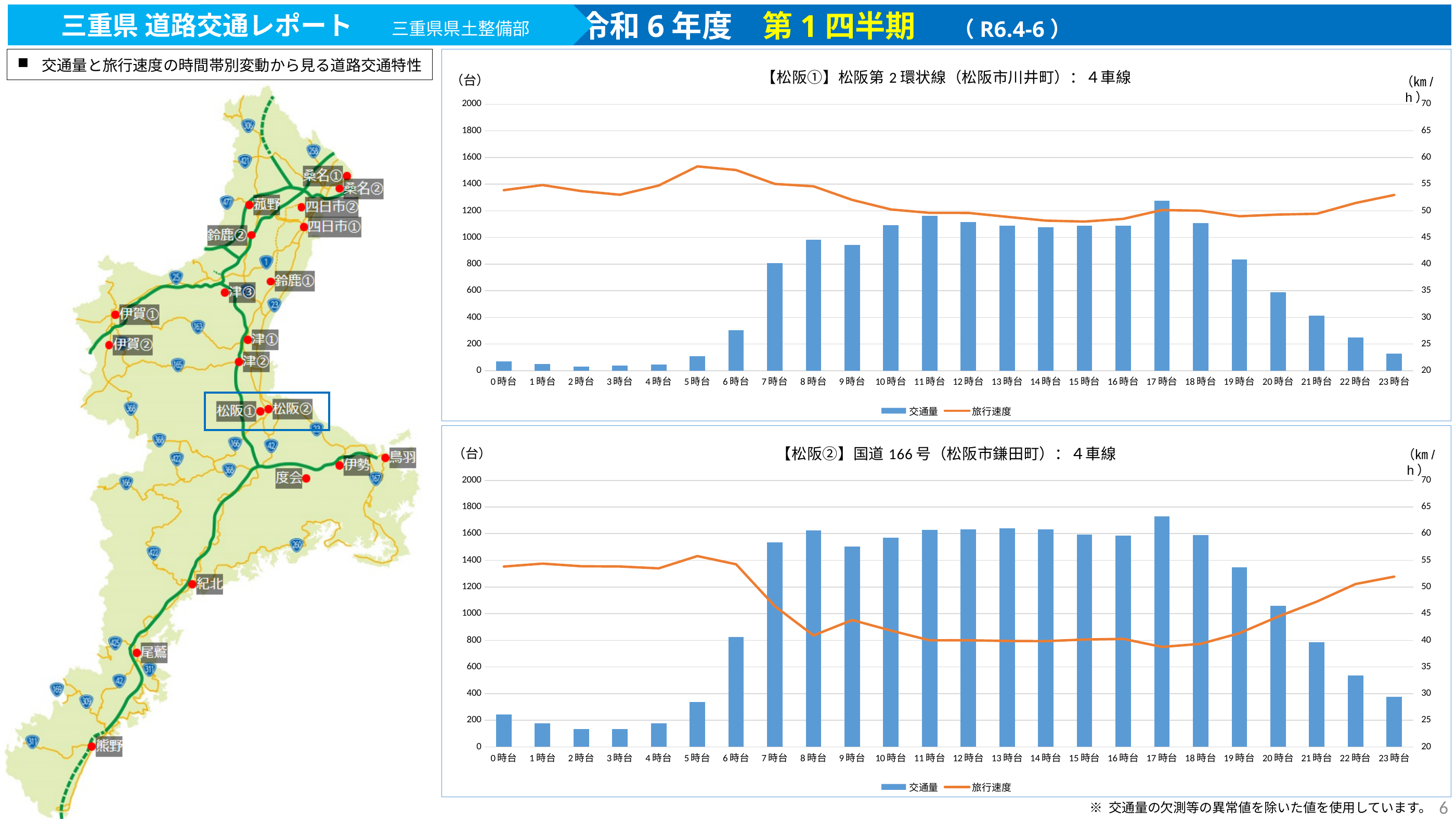
In the top chart (松阪①), which hour has the highest 交通量 bar? 17時台 In the top chart (松阪①), which hour has the lowest 交通量 bar? 2時台 In the bottom chart (松阪②), is the 交通量 value for 6時台 greater or less than 600? greater In the bottom chart (松阪②), which hour has the larger 交通量, 19時台 or 20時台? 19時台 What kind of chart is the top chart titled 【松阪①】松阪第2環状線（松阪市川井町）：4車線? Combined bar and line chart In the top chart (松阪①), which hour has the larger 交通量, 7時台 or 8時台? 8時台 In the bottom chart (松阪②), is the 交通量 value for 8時台 greater or less than 1400? greater In the top chart (松阪①), is the 交通量 value for 11時台 greater or less than 1000? greater How many hour categories are shown on the x axis of the bottom chart (松阪②)? 24 In the bottom chart (松阪②), which hour has the highest 交通量 bar? 17時台 How many series does the legend of the top chart (松阪①) list? 2